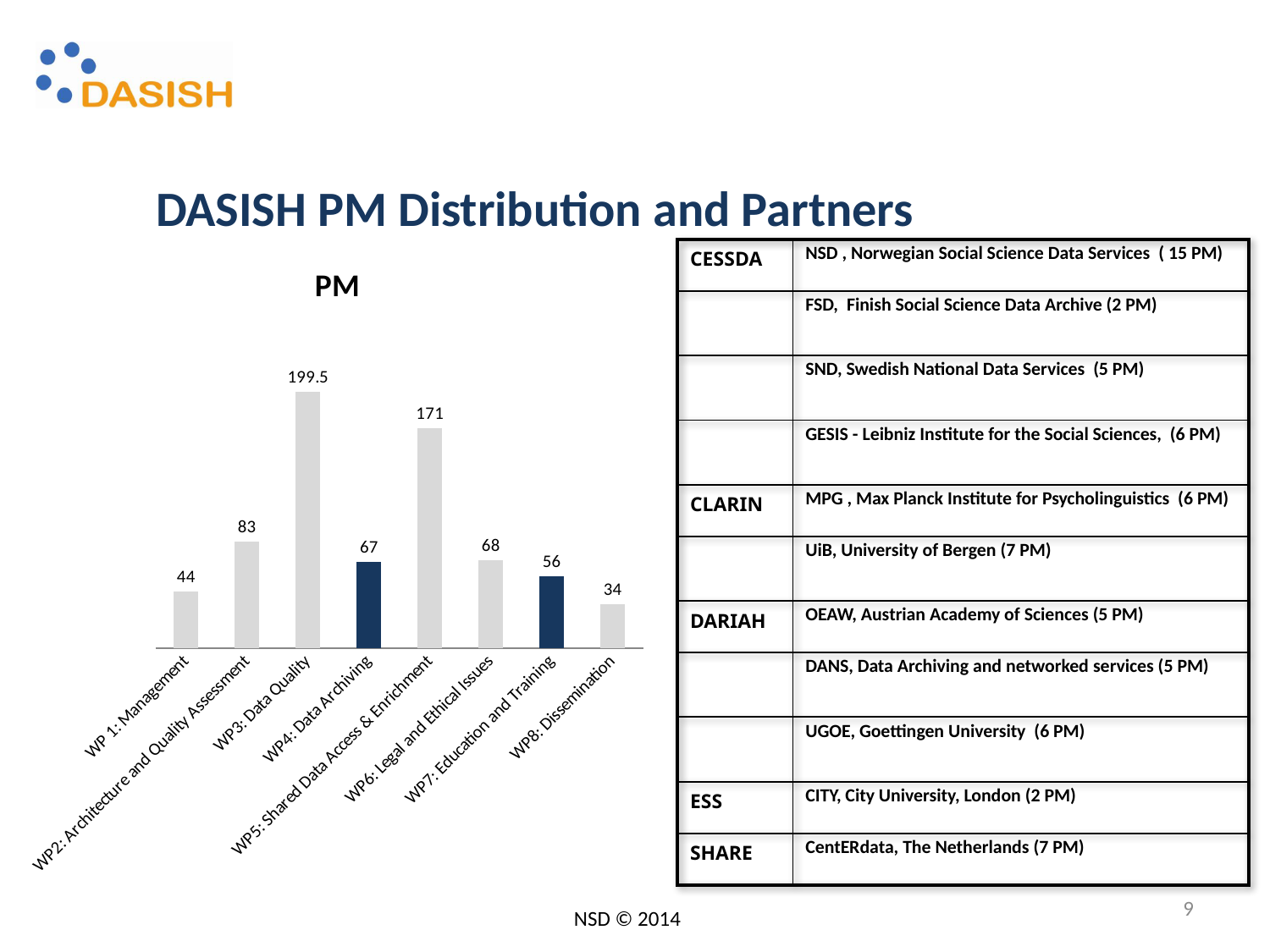
What is the value for WP5: Shared Data Access & Enrichment? 171 What is the title of the chart? PM What is the difference between the values for WP2: Architecture and Quality Assessment and WP7: Education and Training? 27 What is the value for WP8: Dissemination? 34 Which work package has the lowest PM value? WP8: Dissemination Which is larger, the value for WP4: Data Archiving or WP6: Legal and Ethical Issues? WP6: Legal and Ethical Issues What kind of chart is the PM chart? bar chart How many work packages are shown in the PM chart? 8 Which work package has the highest PM value? WP3: Data Quality What is the value for WP 1: Management? 44 What is the difference between the values for WP3: Data Quality and WP5: Shared Data Access & Enrichment? 28.5 What is the value for WP3: Data Quality in the PM chart? 199.5